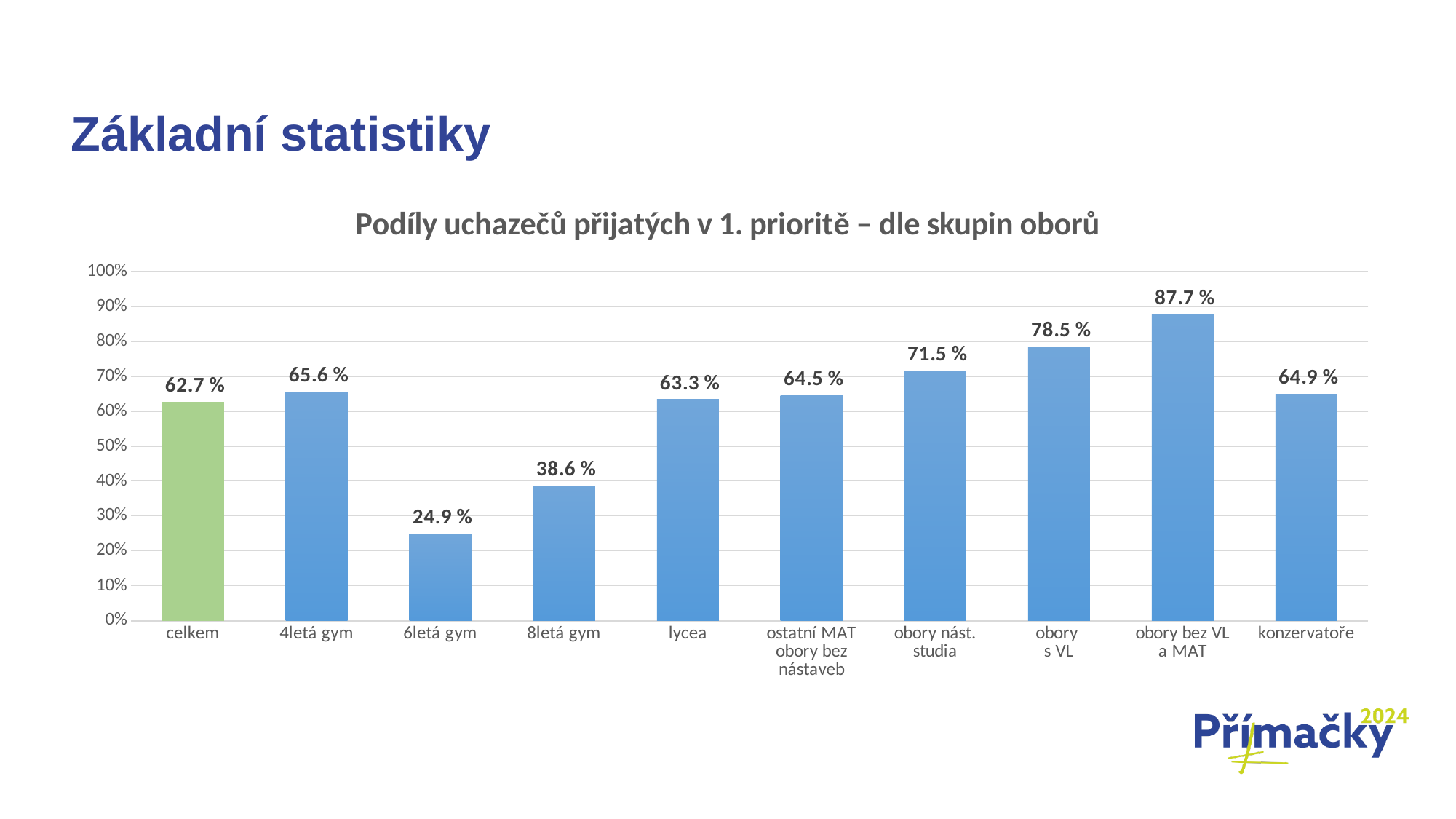
How many categories are shown on the x axis? 10 What is the difference between the values for 'obory bez VL a MAT' and '6letá gym'? 62.8 % What is the value for '6letá gym'? 24.9 % Which is larger, the value for '8letá gym' or the value for 'lycea'? lycea Is the value for 'obory nást. studia' greater or less than 70%? greater What is the title of the chart? Podíly uchazečů přijatých v 1. prioritě – dle skupin oborů Which category has the highest value? obory bez VL a MAT Which bar is coloured green rather than blue? celkem What is the value for 'celkem'? 62.7 % Which category has the lowest value? 6letá gym What is the value for 'obory s VL'? 78.5 % What kind of chart is shown on the slide? bar chart